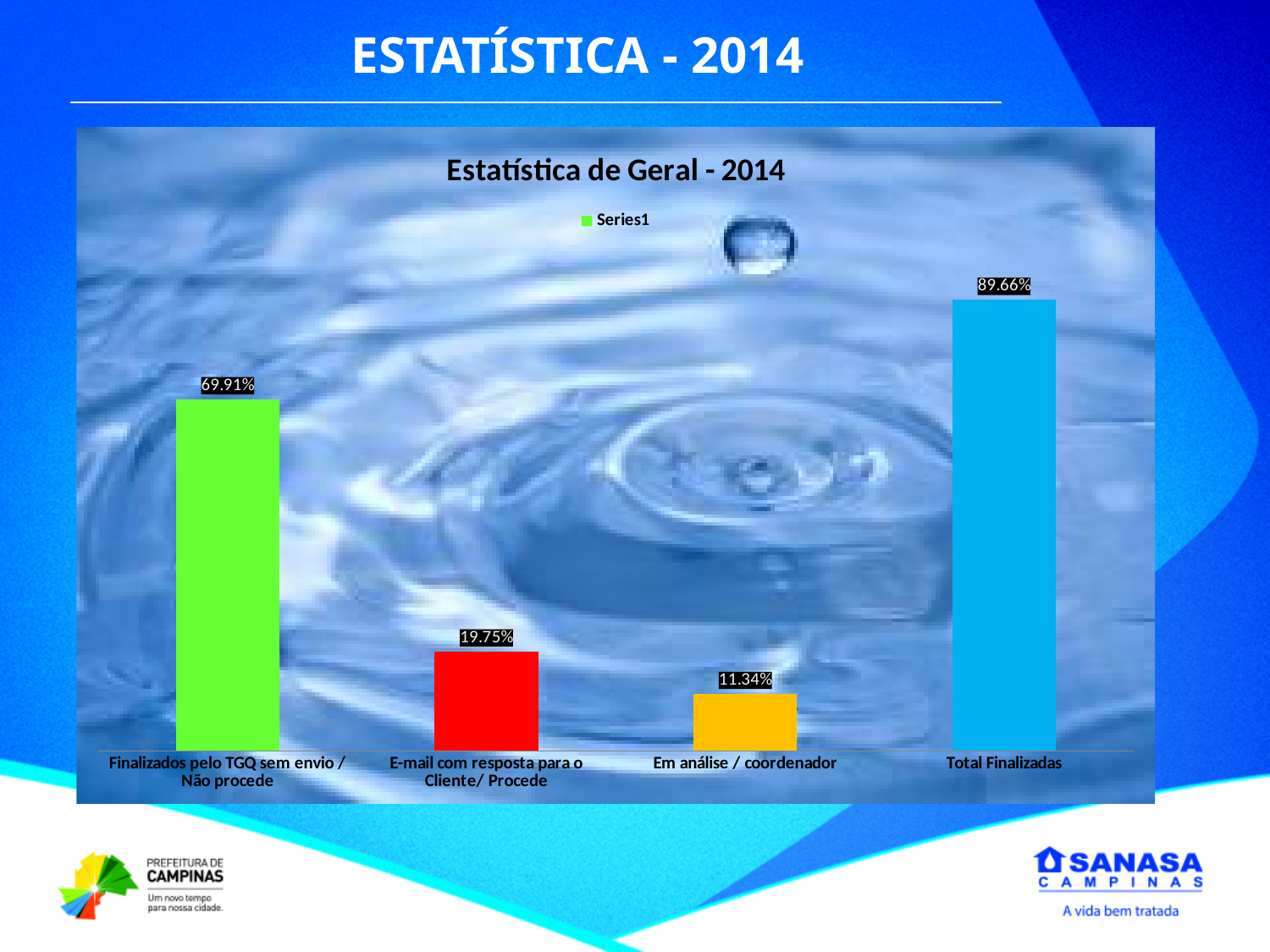
What kind of chart is shown on the slide? Bar chart What is the value for Em análise / coordenador? 11.34% What is the difference between the values for E-mail com resposta para o Cliente/ Procede and Em análise / coordenador? 8.41% What is the title of the chart? Estatística de Geral - 2014 What is the difference between the values for Total Finalizadas and Finalizados pelo TGQ sem envio / Não procede? 19.75% What is the value for Total Finalizadas? 89.66% What is the value for E-mail com resposta para o Cliente/ Procede? 19.75% Which is larger, the value for E-mail com resposta para o Cliente/ Procede or the value for Em análise / coordenador? E-mail com resposta para o Cliente/ Procede What is the value for Finalizados pelo TGQ sem envio / Não procede? 69.91% Which category has the lowest value? Em análise / coordenador Which category has the highest value? Total Finalizadas How many categories are shown in the chart? 4